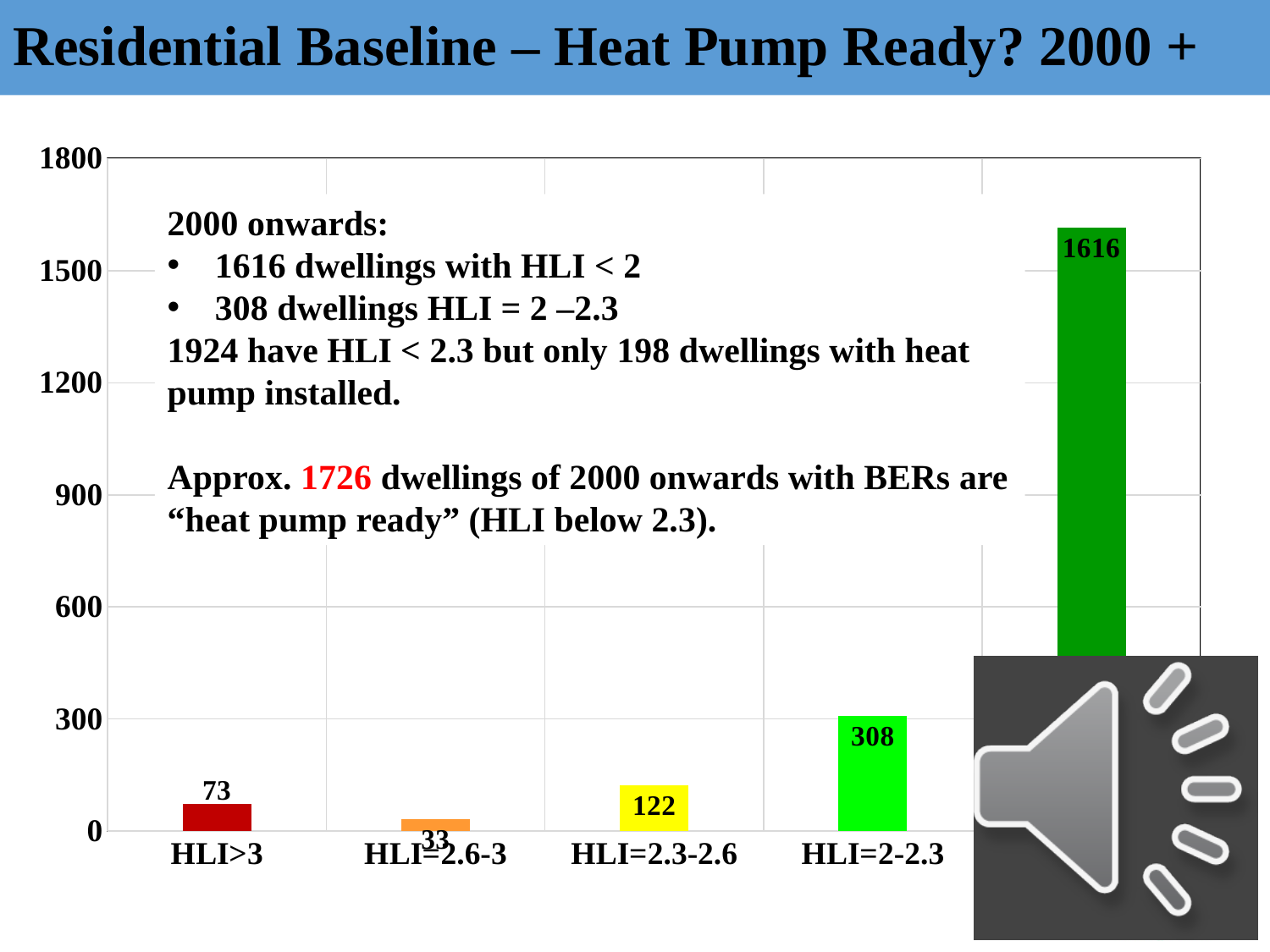
Is the value for HLI=2-2.3 greater or less than 600? less What type of chart is shown on the slide? bar chart Which is larger, the value for HLI>3 or the value for HLI=2.3-2.6? HLI=2.3-2.6 What is the value of the tallest bar in the chart? 1616 What is the value for HLI>3? 73 What is the difference between the values for HLI=2-2.3 and HLI=2.3-2.6? 186 What is the value for HLI=2.6-3? 33 How many bars are plotted in the chart? 5 What is the value for HLI=2.3-2.6? 122 What is the value for HLI=2-2.3? 308 What is the title of the slide containing the chart? Residential Baseline – Heat Pump Ready? 2000 + Which category has the lowest value? HLI=2.6-3